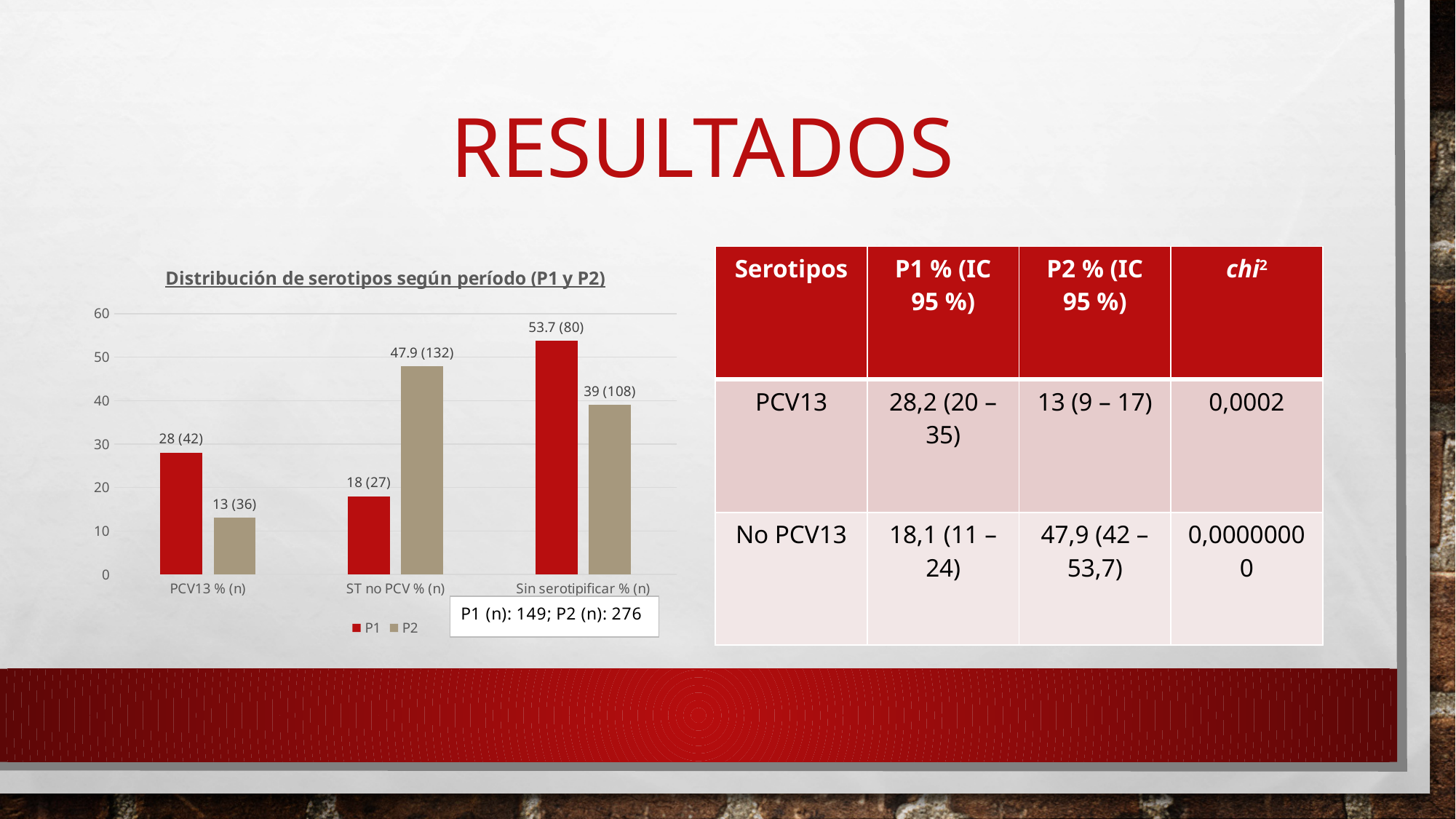
What type of chart is shown on the slide? Bar chart What is the difference between the P1 and P2 percentages in the PCV13 % (n) category? 15 In the ST no PCV % (n) category, which series has the larger value, P1 or P2? P2 What is the data label for P2 in the ST no PCV % (n) category? 47.9 (132) Which category has the highest P1 value? Sin serotipificar % (n) Which category has the lowest P2 value? PCV13 % (n) How many categories are shown on the x axis of the chart? 3 Is the P2 value for Sin serotipificar % (n) greater or less than 40? less What is the data label for P1 in the Sin serotipificar % (n) category? 53.7 (80) What is the data label for P2 in the PCV13 % (n) category? 13 (36) What is the data label for P1 in the PCV13 % (n) category? 28 (42) How many series does the chart legend list? 2